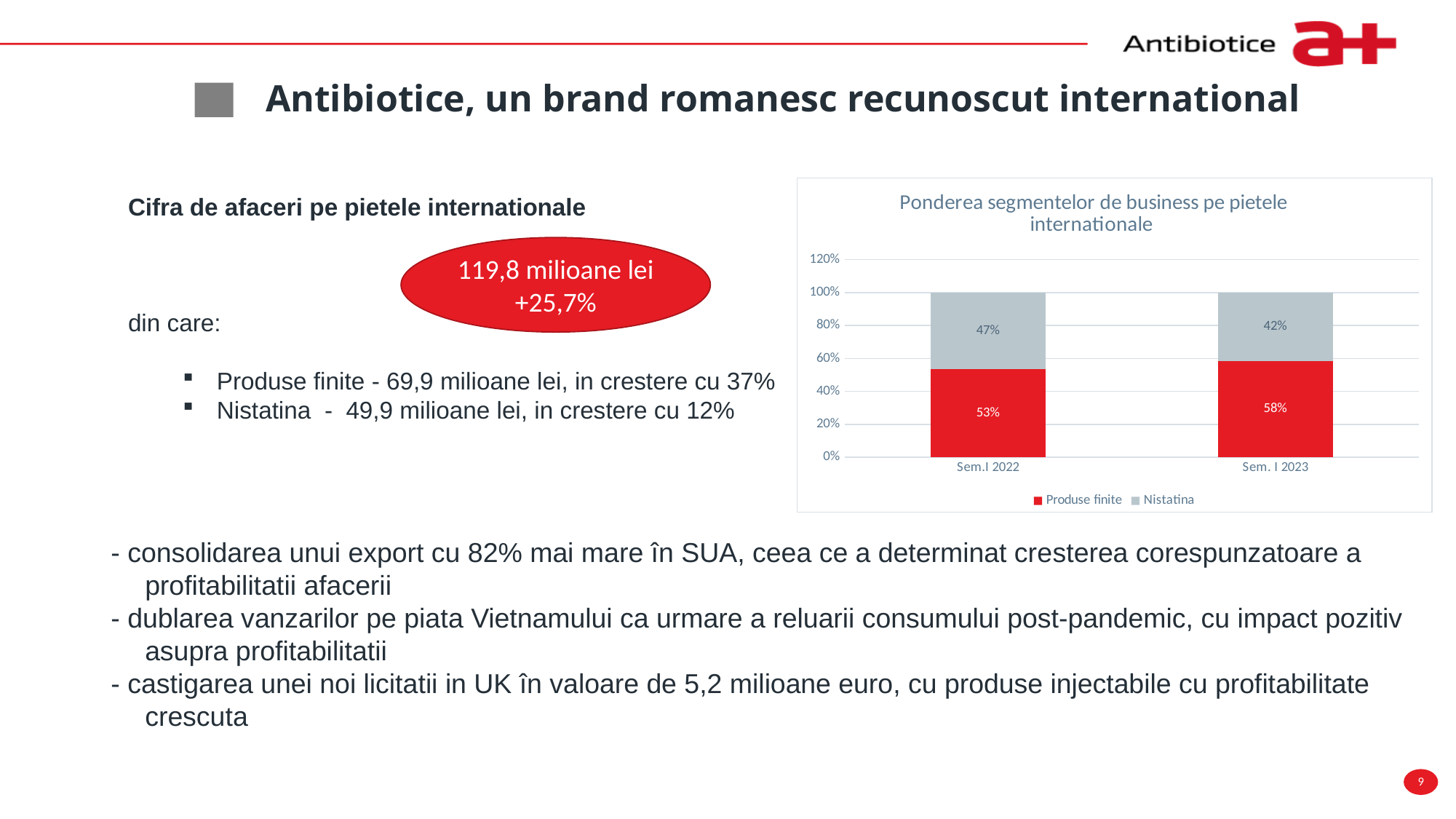
Which is larger in Sem.I 2022: Produse finite or Nistatina? Produse finite What is the value for Produse finite in Sem. I 2023? 58% What is the title of the chart? Ponderea segmentelor de business pe pietele internationale What kind of chart is shown? Stacked bar chart How many periods are shown on the x axis? 2 How many series does the legend list? 2 What is the value for Produse finite in Sem.I 2022? 53% In which period is the Nistatina share lowest? Sem. I 2023 What is the value for Nistatina in Sem. I 2023? 42% In which period is the Produse finite share highest? Sem. I 2023 What is the difference between the Produse finite share in Sem. I 2023 and in Sem.I 2022? 5% What is the value for Nistatina in Sem.I 2022? 47%